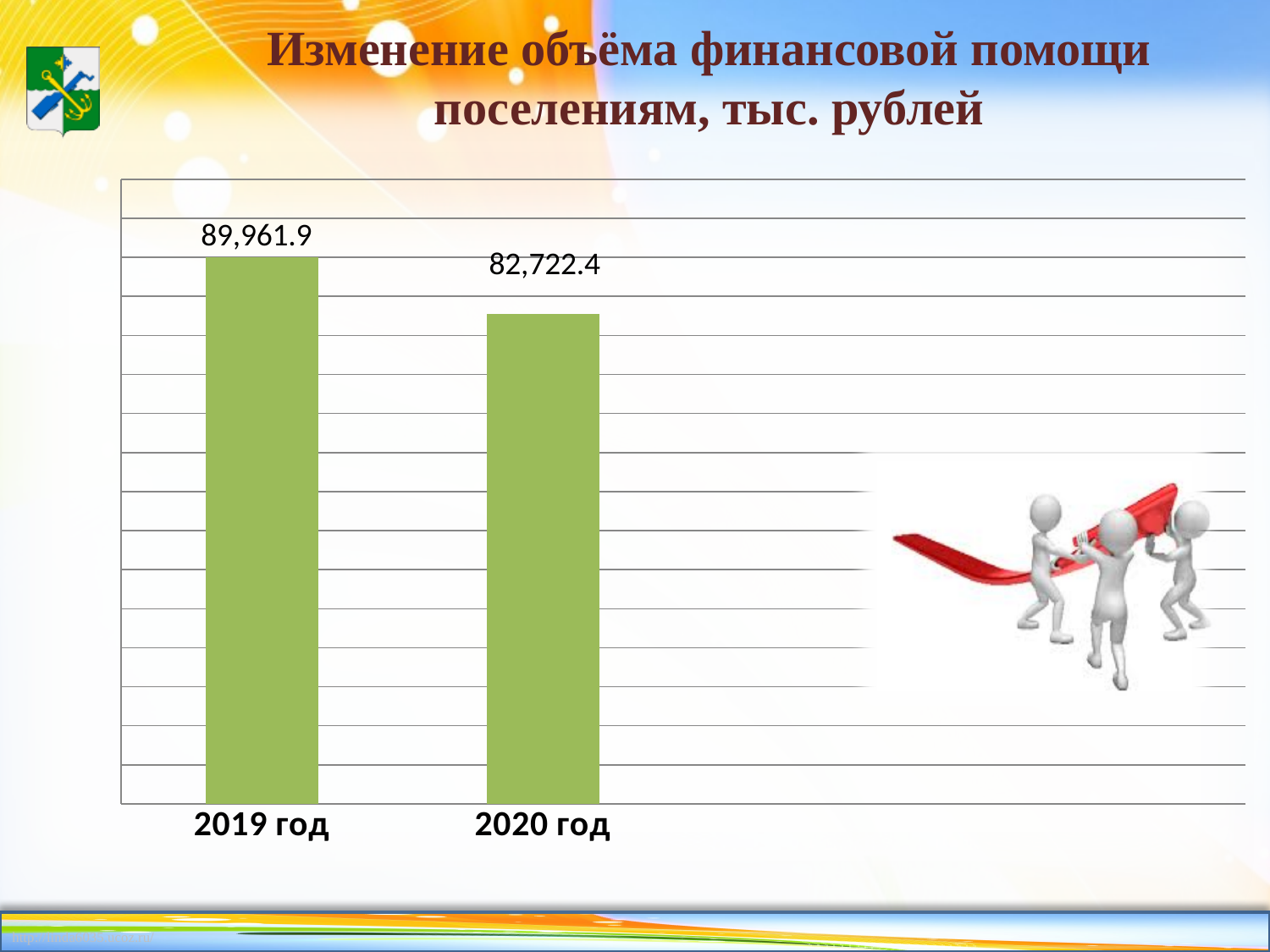
What kind of chart is shown on the slide? Bar chart Which year has the lowest value? 2020 год What is the title of the chart? Изменение объёма финансовой помощи поселениям, тыс. рублей What colour are the bars in the chart? Green What is the value for 2020 год? 82,722.4 What is the value for 2019 год? 89,961.9 What is the difference between the values for 2019 год and 2020 год? 7,239.5 How many categories are shown on the chart? 2 Which is larger, the value for 2019 год or the value for 2020 год? 2019 год Do the values rise or fall from 2019 год to 2020 год? Fall Which year has the highest value? 2019 год